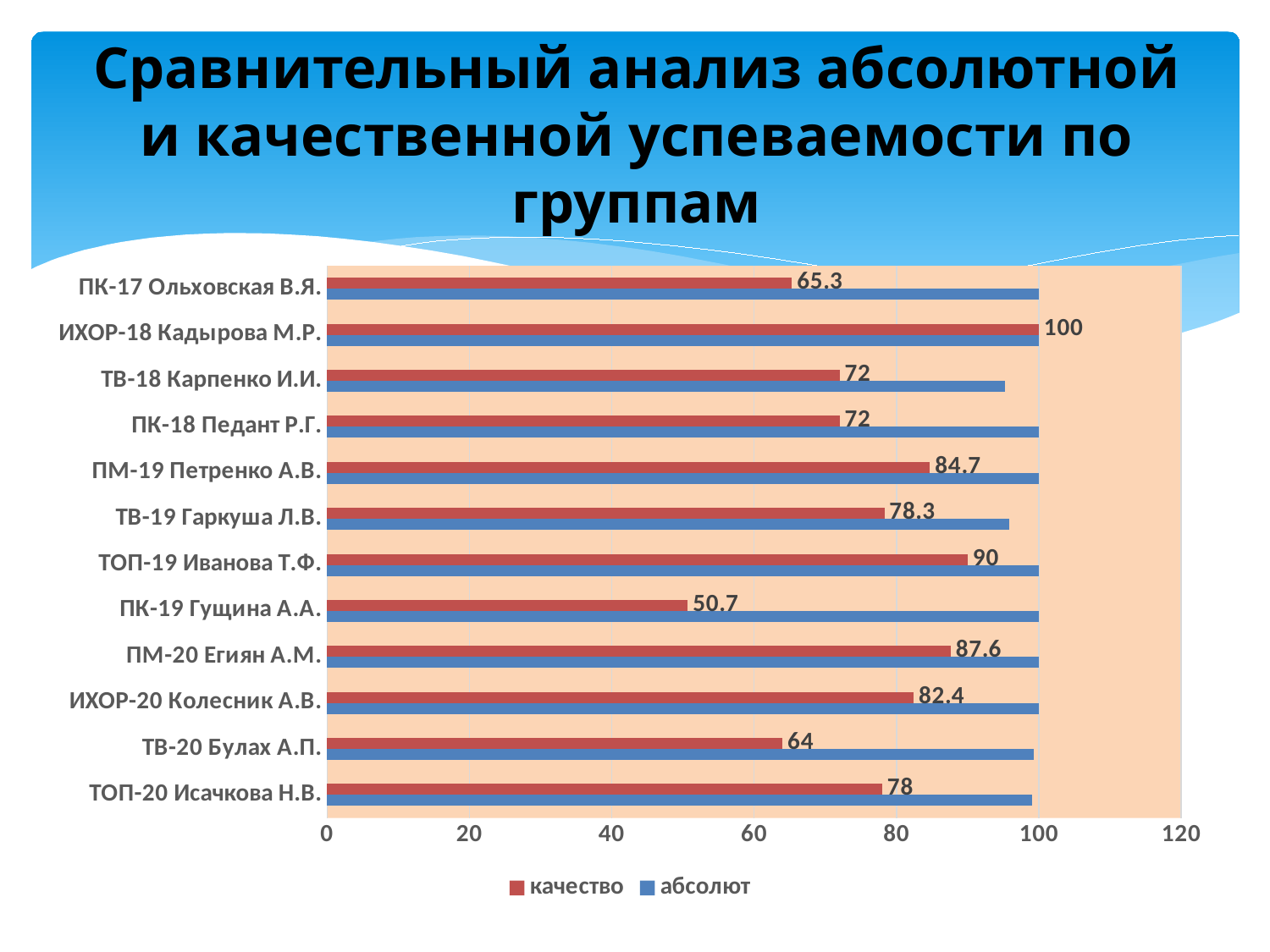
What is the качество value for ПК-19 Гущина А.А.? 50.7 What is the difference between the качество values of ИХОР-18 Кадырова М.Р. and ПК-19 Гущина А.А.? 49.3 Which group has the lowest качество value? ПК-19 Гущина А.А. What is the качество value for ПМ-19 Петренко А.В.? 84.7 What kind of chart is shown on the slide? bar chart What is the качество value for ИХОР-20 Колесник А.В.? 82.4 Which colour represents the качество series? red Which has the larger качество value: ТОП-19 Иванова Т.Ф. or ТВ-20 Булах А.П.? ТОП-19 Иванова Т.Ф. How many series does the legend list? 2 Which group has the highest качество value? ИХОР-18 Кадырова М.Р. Is the абсолют value for ТВ-18 Карпенко И.И. greater or less than 80? greater How many groups are shown on the chart? 12